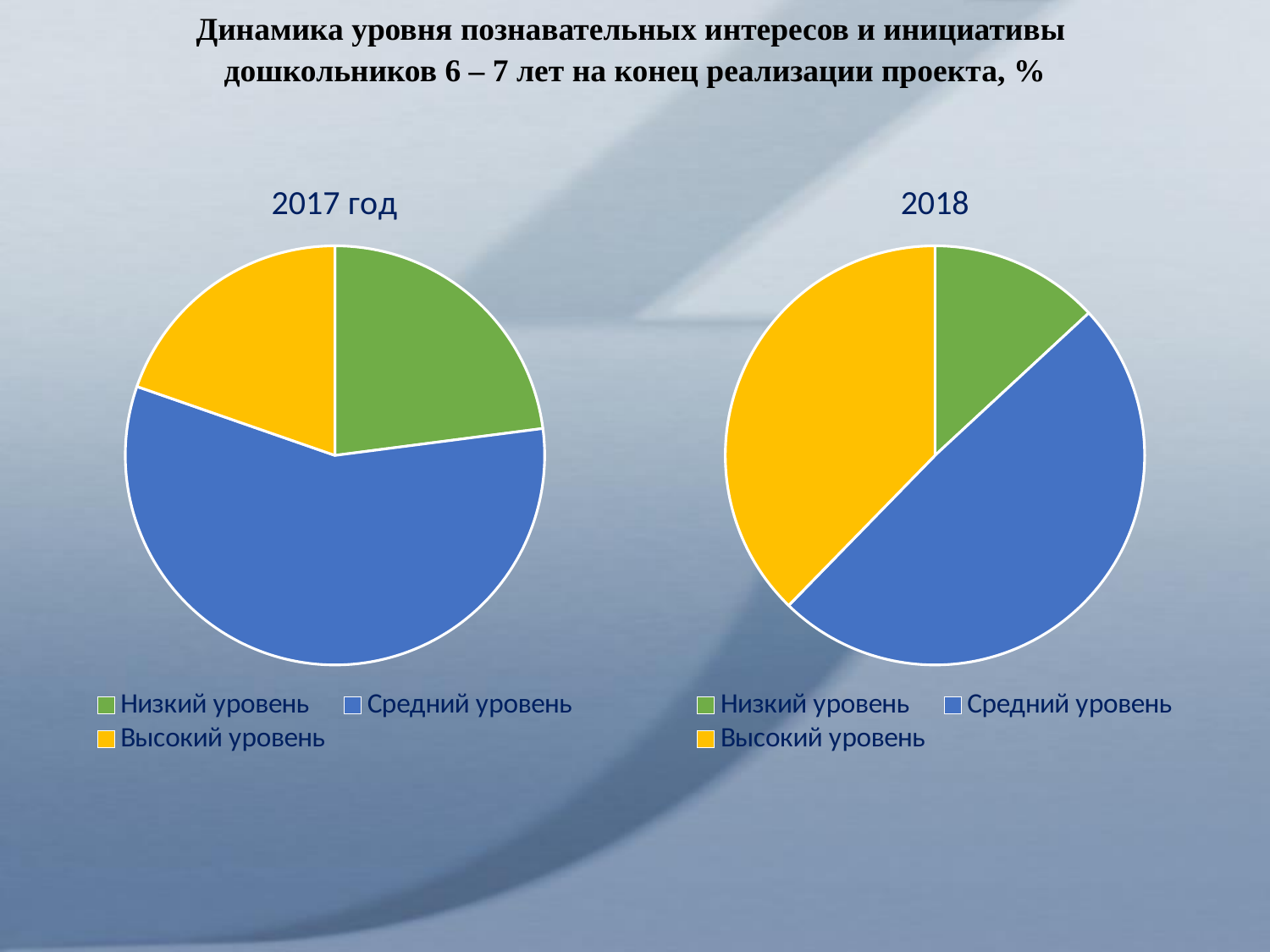
What kind of chart is the 2017 год chart? pie chart How many slices does the 2018 pie chart have? 3 How many slices does the 2017 год pie chart have? 3 In the 2018 chart, which level has the largest slice? Средний уровень In the 2018 chart, which level has the smallest slice? Низкий уровень What kind of chart is the 2018 chart? pie chart What colour represents Высокий уровень in the 2018 chart? yellow In the 2018 chart, which slice is larger: Высокий уровень or Низкий уровень? Высокий уровень How many entries does the legend of the 2017 год chart list? 3 In the 2017 год chart, which slice is larger: Низкий уровень or Высокий уровень? Низкий уровень In the 2017 год chart, which level has the largest slice? Средний уровень In the 2017 год chart, which level has the smallest slice? Высокий уровень